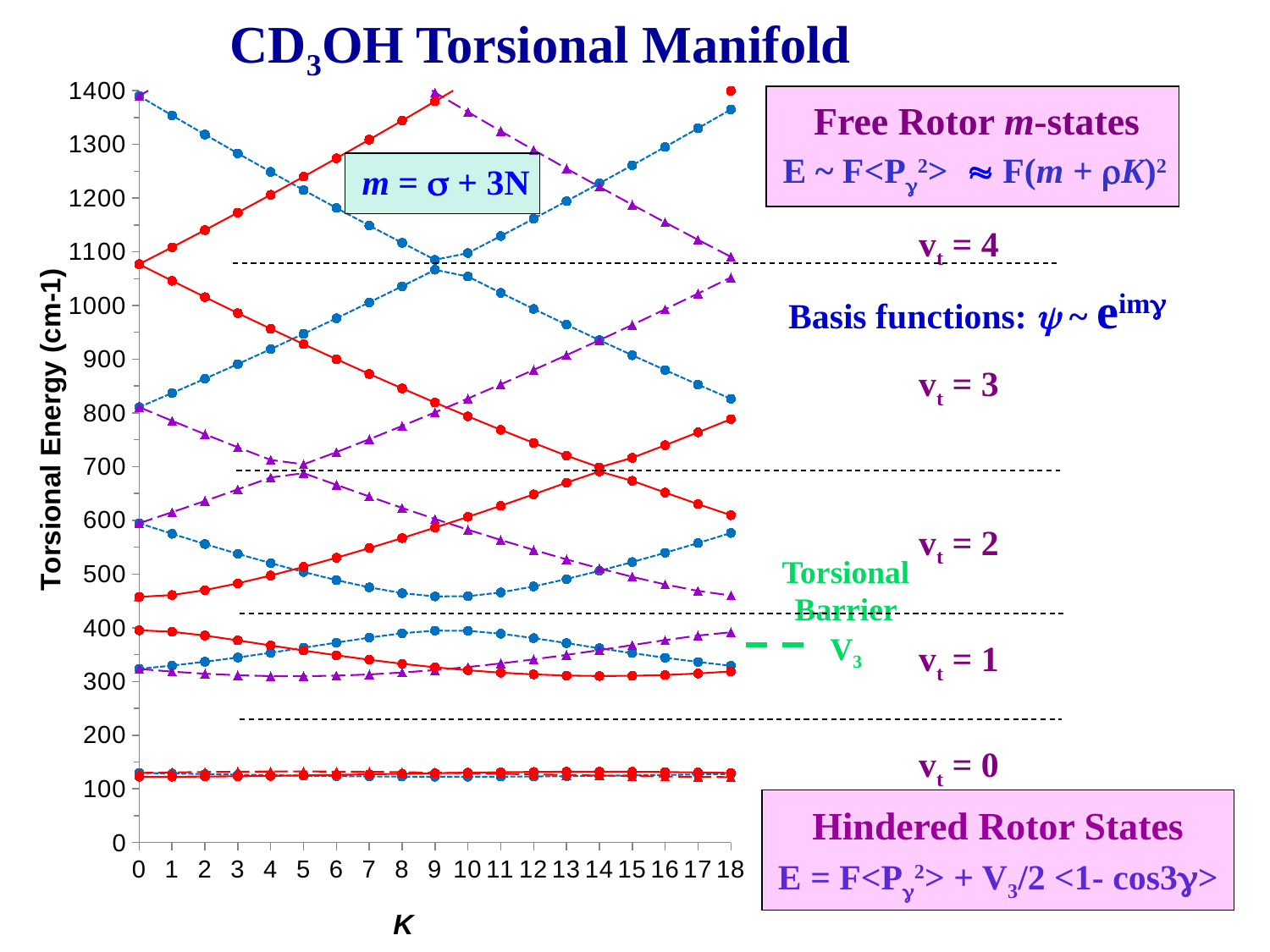
At K = 18, is the topmost red point higher or lower than the topmost blue point? higher How many K values are marked along the x axis? 19 What is the largest K value shown on the x axis? 18 Does the red solid line that starts near 460 at K = 0 rise or fall as K increases from 0 to 18? rise What kind of chart is shown on the slide? line chart Is the value of the lowest red line at K = 0 greater or less than 200? less Is the value of the highest red solid line at K = 0 greater or less than 1000? greater What is the label of the vertical axis? Torsional Energy (cm-1) Is the value of the highest blue dashed line at K = 9 greater or less than 1200? less Does the highest blue dashed line rise or fall as K increases from 0 to 9? fall What is the title of the chart? CD3OH Torsional Manifold What is the highest value shown on the vertical axis? 1400